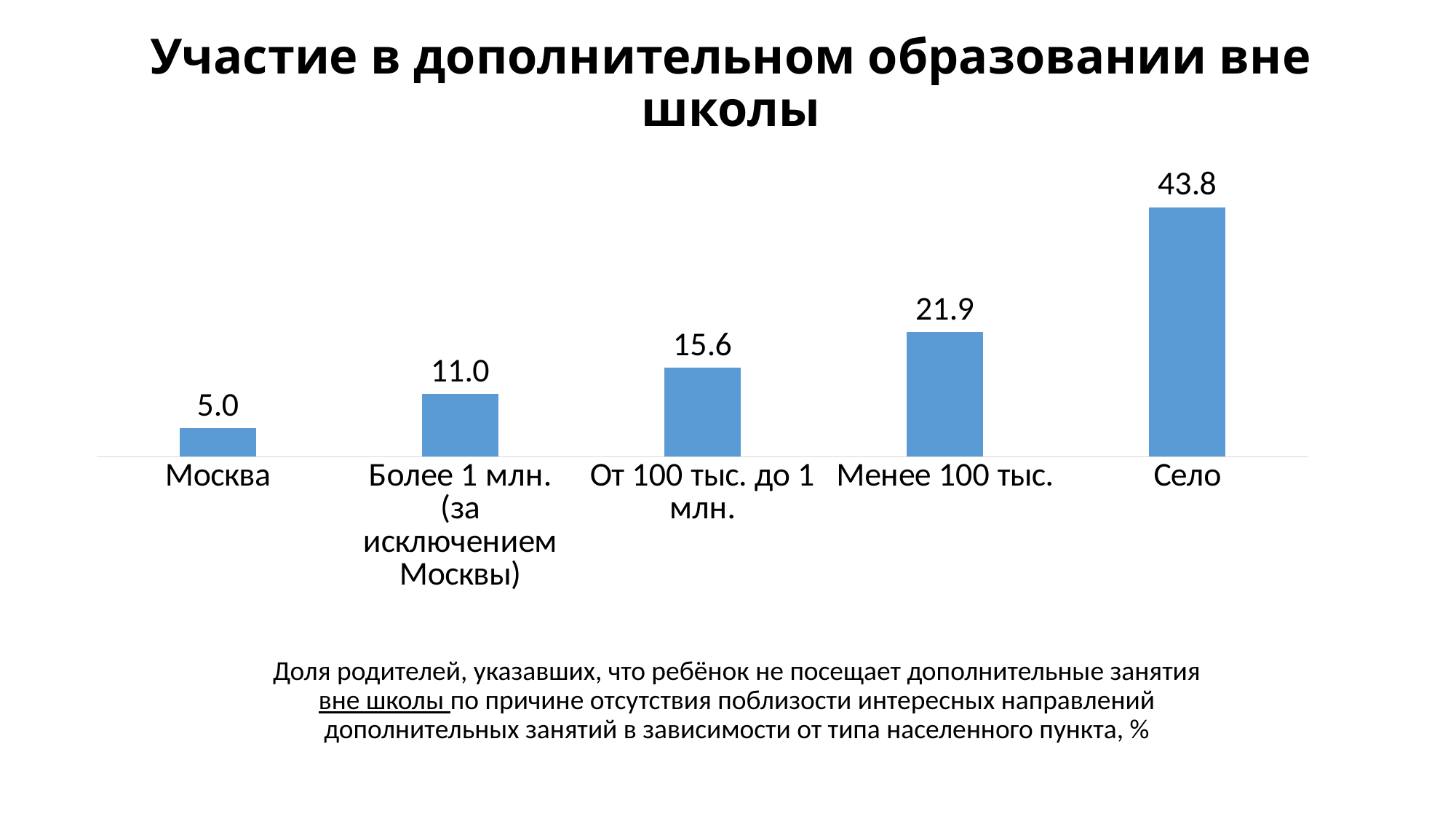
What is the value for Москва? 5.0 Which category has the highest value? Село Which is larger: the value for Более 1 млн. (за исключением Москвы) or the value for От 100 тыс. до 1 млн.? От 100 тыс. до 1 млн. What is the difference between the values for Менее 100 тыс. and От 100 тыс. до 1 млн.? 6.3 What kind of chart is shown on the slide? Bar chart What is the value for От 100 тыс. до 1 млн.? 15.6 Do the values rise or fall from left to right along the x axis? Rise How many categories are shown on the chart? 5 What is the value for Менее 100 тыс.? 21.9 Which category has the lowest value? Москва What is the value for Село? 43.8 What is the difference between the values for Село and Москва? 38.8